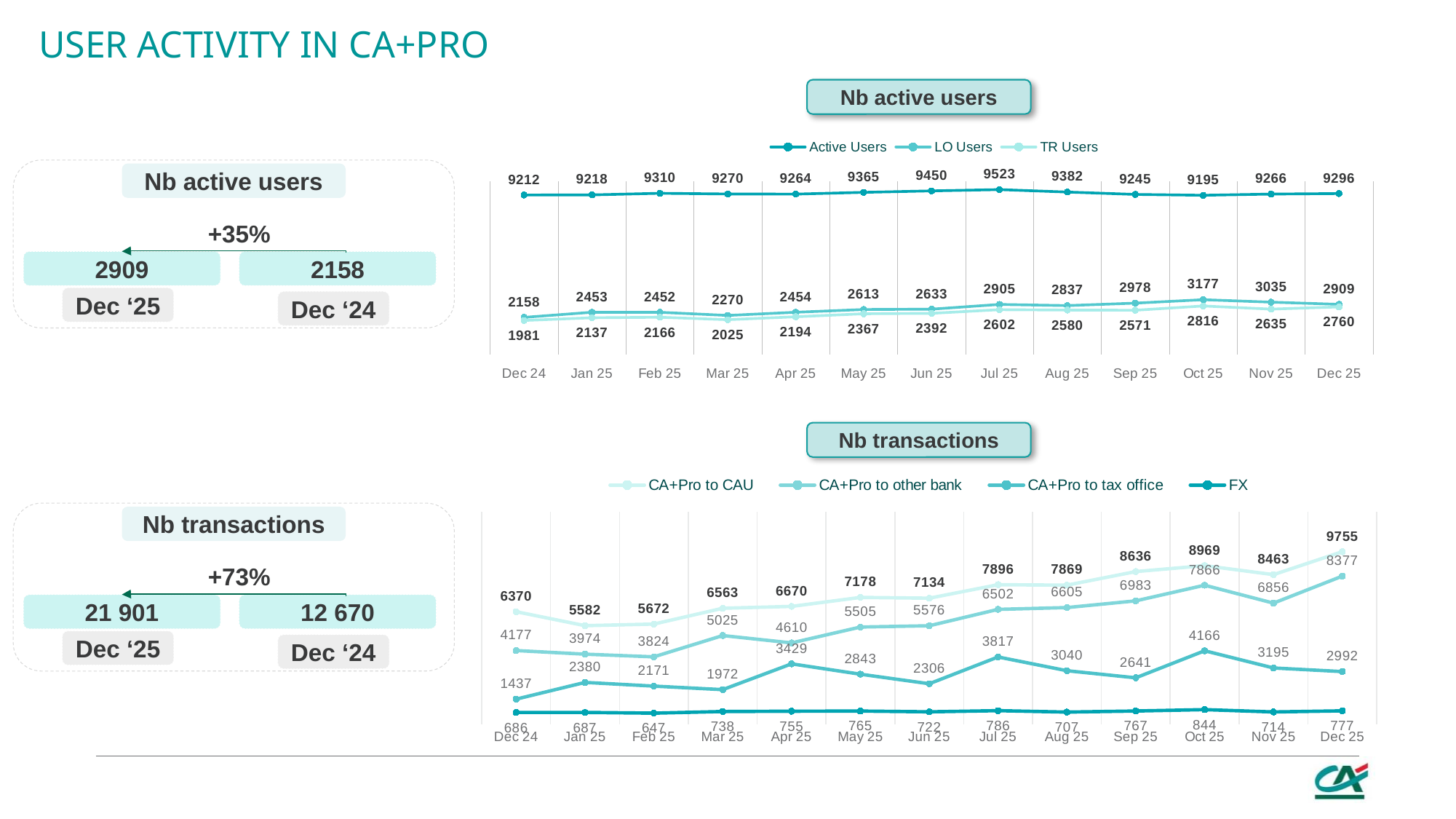
What kind of chart is the Nb transactions chart? Line chart In the Nb active users chart, what is the value for LO Users in Oct 25? 3177 In the Nb active users chart, in which month is the Active Users series highest? Jul 25 In the Nb transactions chart, what is the value for CA+Pro to CAU in Dec 25? 9755 In the Nb active users chart, what is the value for Active Users in Jul 25? 9523 In the Nb transactions chart, which is larger in Mar 25: CA+Pro to other bank or CA+Pro to tax office? CA+Pro to other bank How many months are plotted on the x axis of the Nb transactions chart? 13 How many series does the legend of the Nb active users chart list? 3 In the Nb active users chart, what is the difference between LO Users and TR Users in Dec 25? 149 In the Nb transactions chart, in which month is the CA+Pro to tax office series highest? Oct 25 In the Nb active users chart, in which month is the TR Users series lowest? Dec 24 In the Nb transactions chart, what is the difference between the FX values in Oct 25 and Nov 25? 130